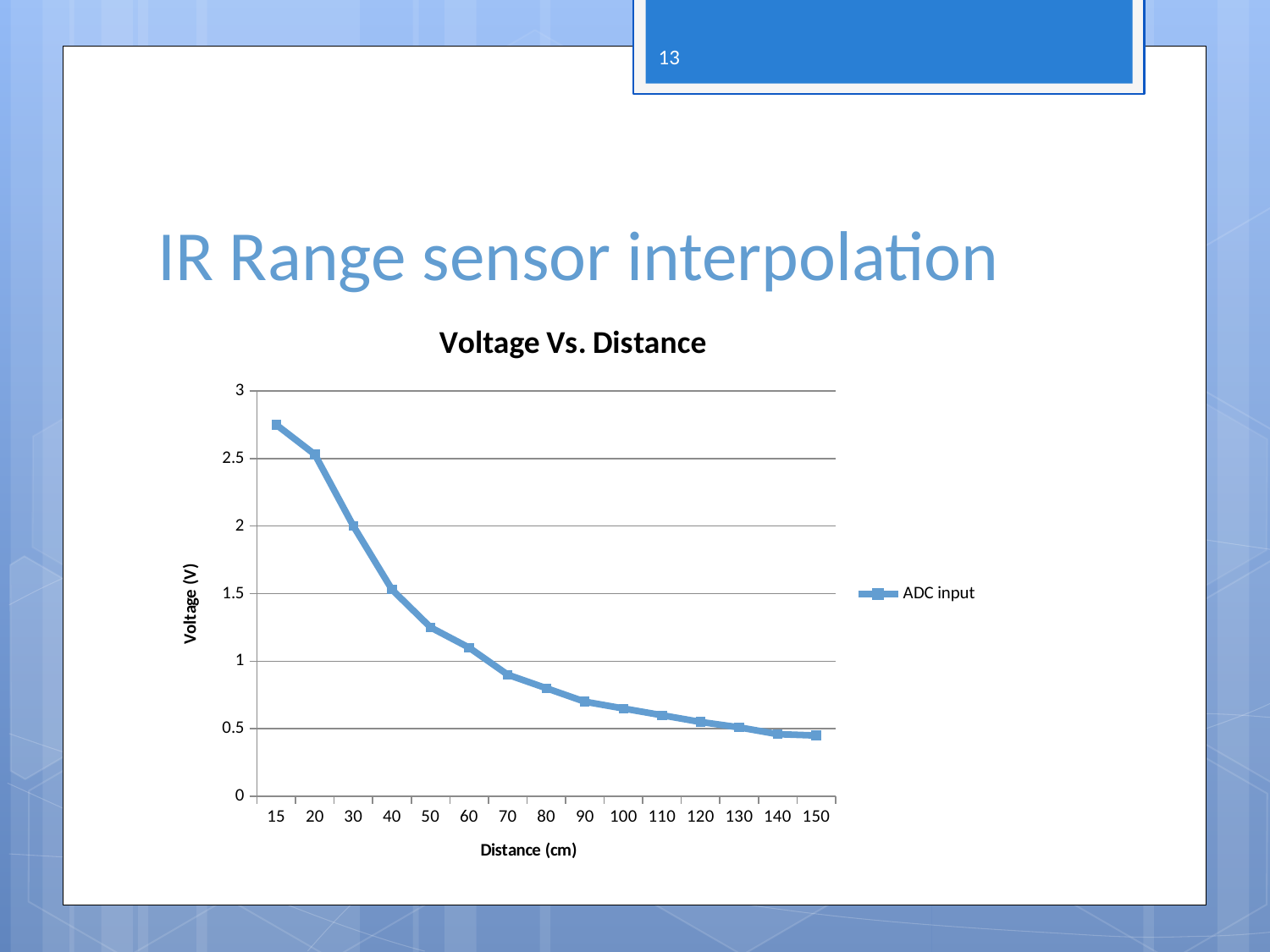
What kind of chart is shown on the slide? line chart How many distance points are plotted on the x axis? 15 Is the voltage at 15 cm greater or less than 2.5? greater How many series does the legend list? 1 Is the voltage at 100 cm greater or less than 0.5? greater Is the voltage at 50 cm greater or less than 1.5? less Which has the larger voltage, 20 cm or 60 cm? 20 cm What is the name of the series shown in the legend? ADC input Does the voltage rise or fall as distance increases along the x axis? fall What is the title of the chart? Voltage Vs. Distance At which distance is the voltage highest? 15